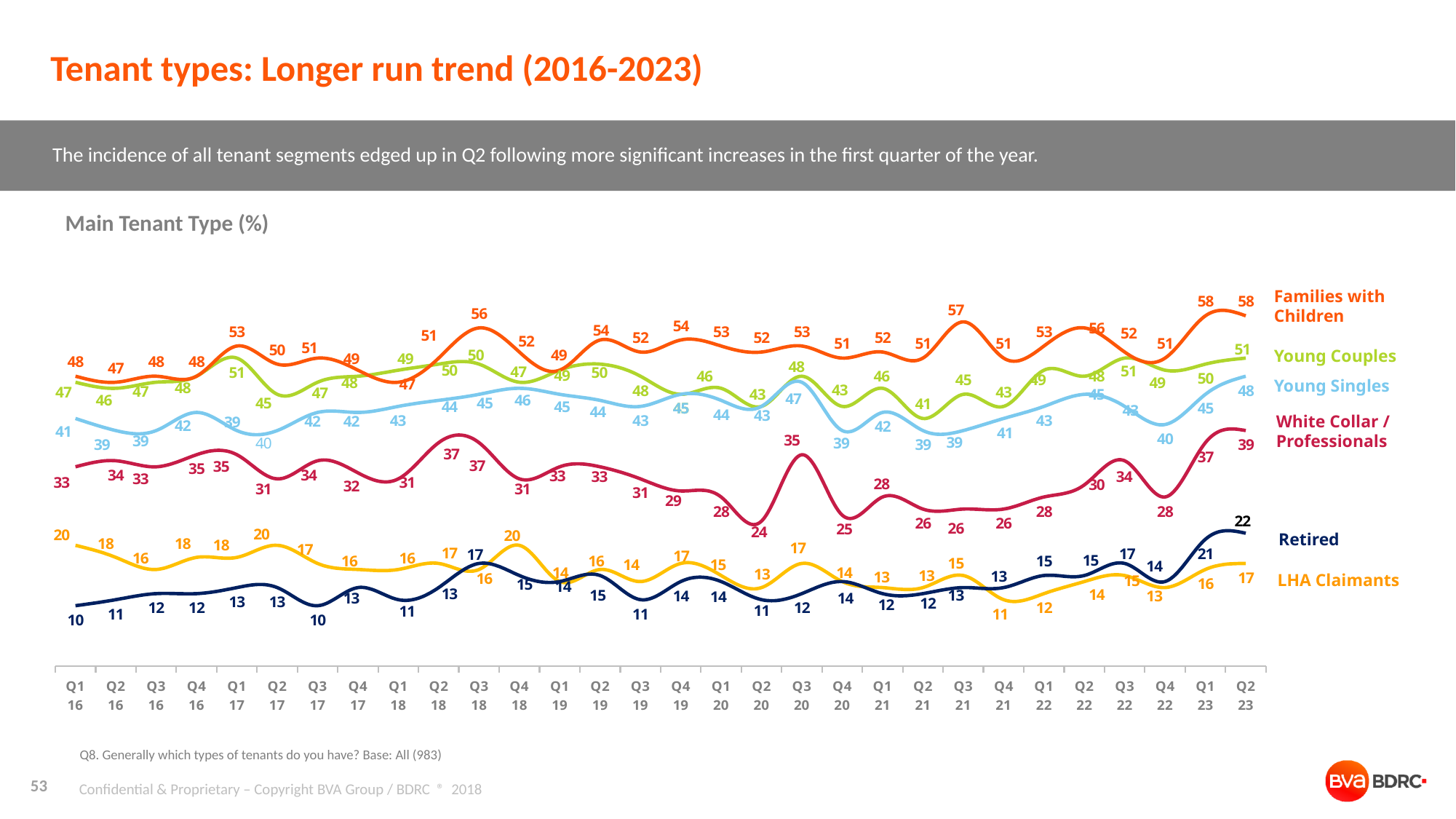
What is the difference between Families with Children and Young Couples in Q2 23? 7 How many quarters are plotted along the x axis? 30 Does the Retired series rise or fall from Q4 22 to Q2 23? Rise In Q3 18, which is larger: Retired or LHA Claimants? Retired What is the value for LHA Claimants in Q4 21? 11 What type of chart is shown on the slide? Line chart How many series does the legend list? 6 What is the value for White Collar / Professionals in Q3 20? 35 In which quarter does White Collar / Professionals reach its lowest value? Q2 20 What is the value for Families with Children in Q2 23? 58 What is the highest value reached by the Families with Children series? 58 What is the value for Retired in Q2 23? 22